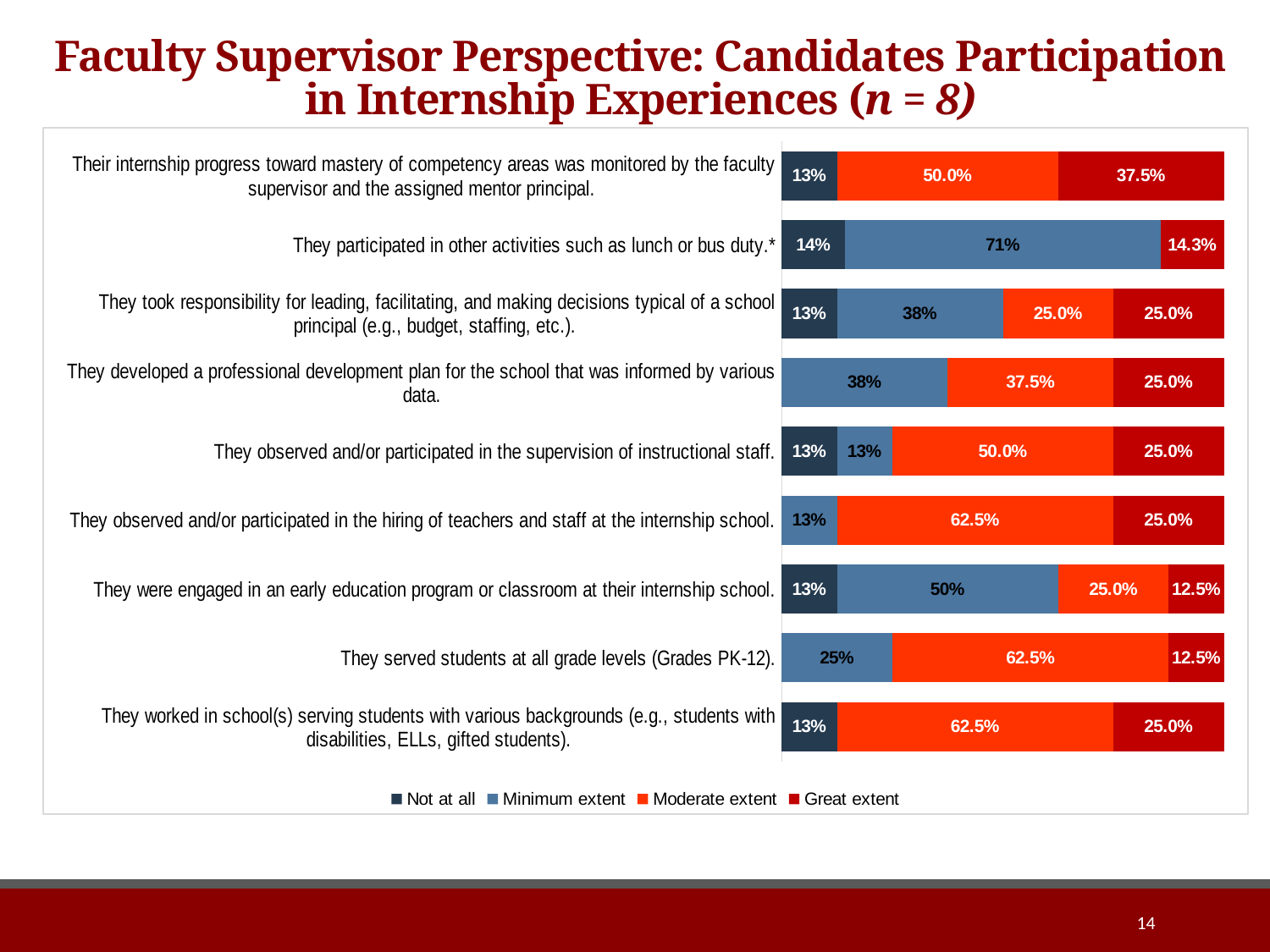
What is the difference between the Moderate extent value and the Great extent value for "They served students at all grade levels (Grades PK-12)."? 50.0% What is the Minimum extent value for "They participated in other activities such as lunch or bus duty.*"? 71% How many series does the legend list? 4 What is the Moderate extent value for "They observed and/or participated in the hiring of teachers and staff at the internship school."? 62.5% Which statement has the highest Great extent value? Their internship progress toward mastery of competency areas was monitored by the faculty supervisor and the assigned mentor principal. What kind of chart is shown on the slide? Stacked bar chart Which statement has the highest Minimum extent value? They participated in other activities such as lunch or bus duty.* What is the Great extent value for "Their internship progress toward mastery of competency areas was monitored by the faculty supervisor and the assigned mentor principal."? 37.5% What is the Minimum extent value for "They were engaged in an early education program or classroom at their internship school."? 50% Which legend entry is shown in the darkest navy colour? Not at all How many statements (categories) are plotted in the chart? 9 For "They took responsibility for leading, facilitating, and making decisions typical of a school principal (e.g., budget, staffing, etc.).", which is larger: the Minimum extent value or the Moderate extent value? Minimum extent